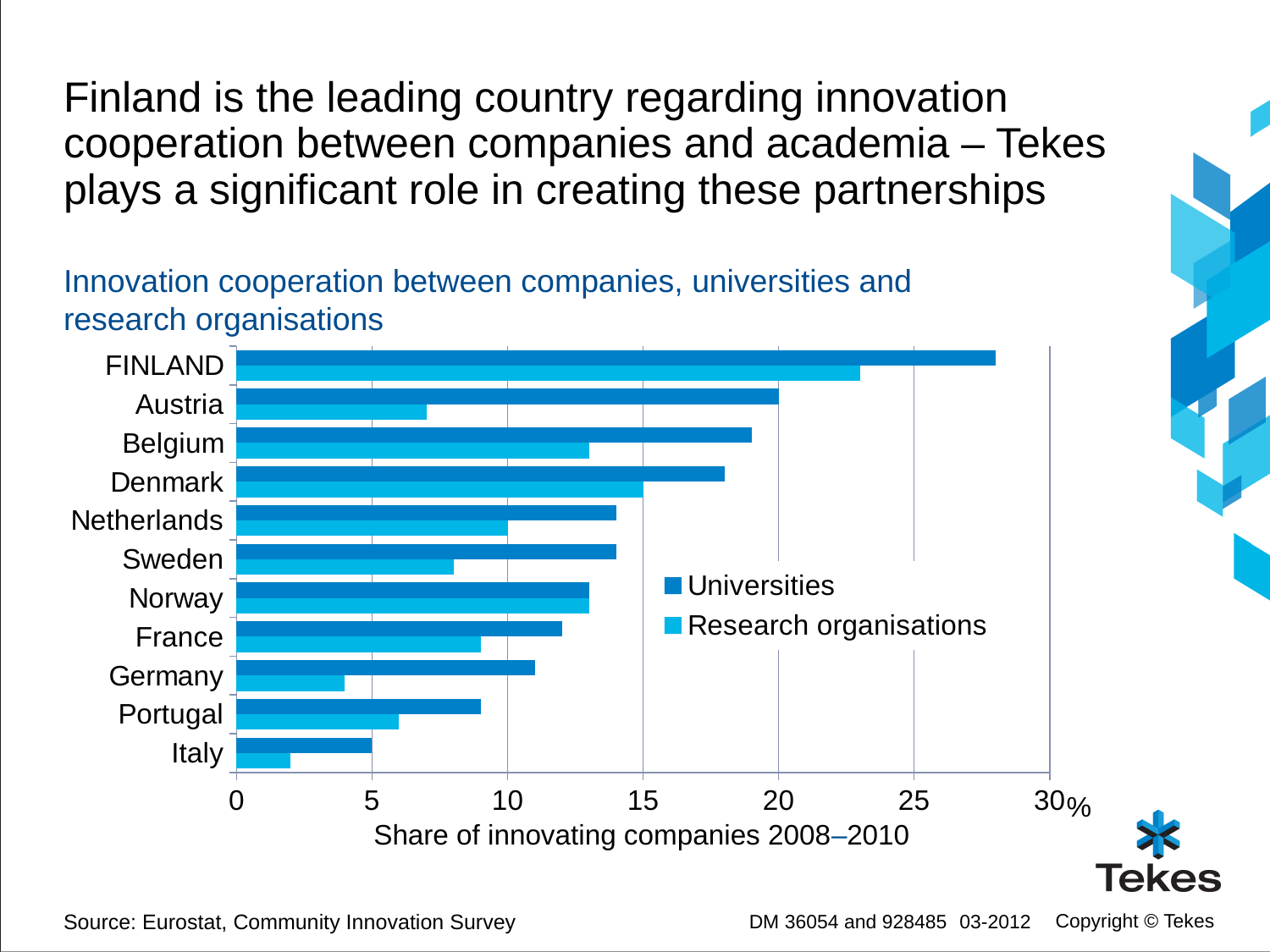
Which country has the lowest value for Universities? Italy Is the Research organisations value for Germany greater or less than 5? less What are the two entries in the chart legend? Universities; Research organisations Is the Universities value for FINLAND greater or less than 25? greater Which country has the lowest value for Research organisations? Italy For Austria, which is larger: the Universities value or the Research organisations value? Universities What kind of chart is shown on the slide? bar chart Which is larger: the Research organisations value for FINLAND or for Austria? FINLAND Which country has the highest value for Universities? FINLAND Is the Universities value for Belgium greater or less than 15? greater How many series does the legend list? 2 How many countries are listed on the chart? 11